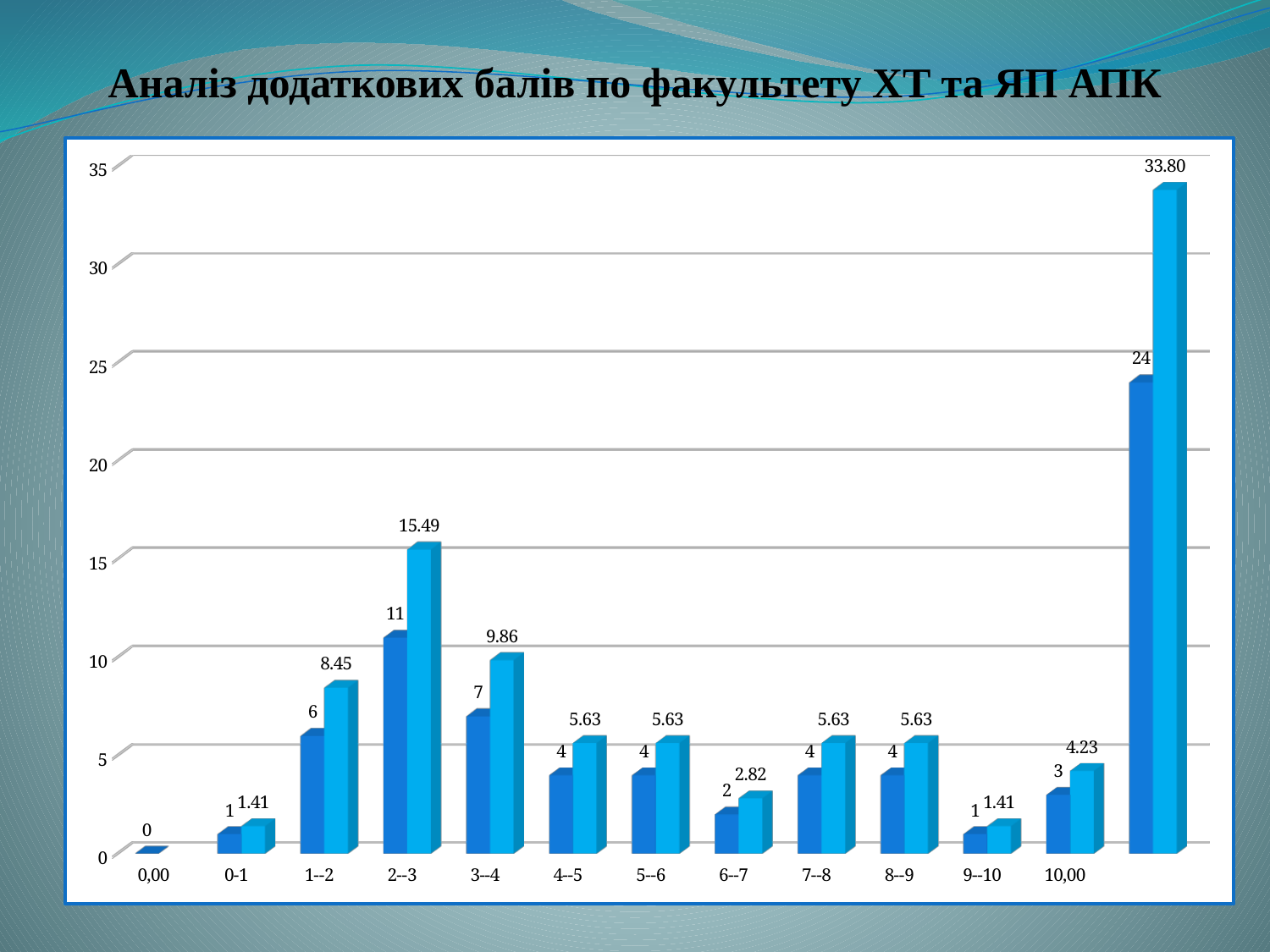
What is the value of the dark blue bar for the category 2--3? 11 Which category has the lowest dark blue bar? 0,00 What is the value of the dark blue bar for the category 1--2? 6 What is the difference between the light blue bars for 2--3 and 3--4? 5.63 What is the value of the light blue bar for the category 2--3? 15.49 What is the title of the chart on the slide? Аналіз додаткових балів по факультету ХТ та ЯП АПК What is the difference between the dark blue bars for 2--3 and 1--2? 5 What is the value of the light blue bar for the category 3--4? 9.86 Which is larger, the light blue bar for 1--2 or the light blue bar for 3--4? 3--4 What is the value of the light blue bar for the category 6--7? 2.82 What kind of chart is shown on the slide? bar chart Is the value of the tallest light blue bar greater or less than 30? greater